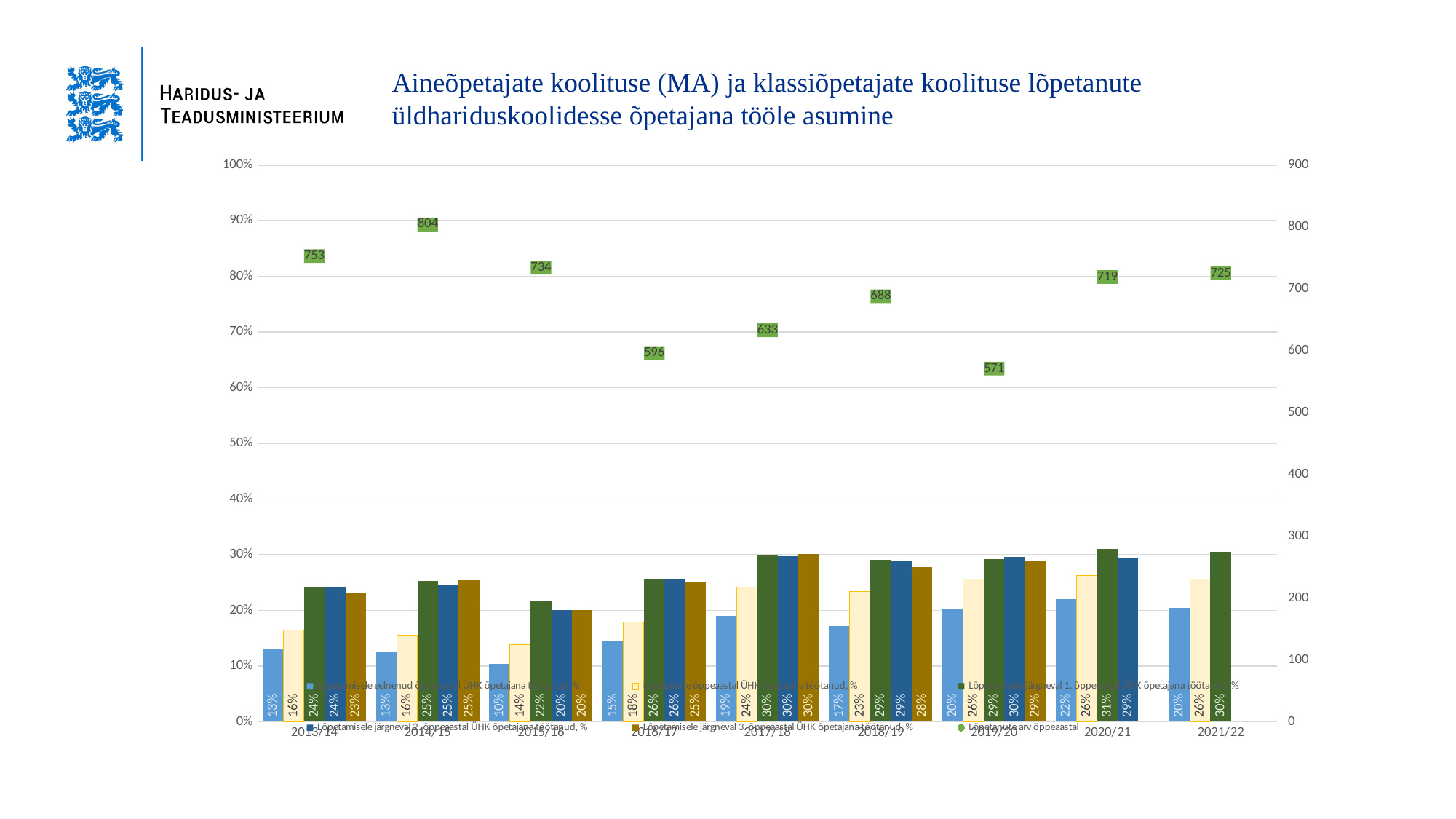
How many series does the legend list? 6 Which academic year has the highest number of graduates? 2014/15 Which academic year has the lowest number of graduates? 2019/20 What is the value of the dark green bar for 2020/21? 31% What is the value of the light blue bar (first bar) for 2015/16? 10% How many academic years are shown on the x axis? 9 Is the number of graduates in 2017/18 greater or less than 600? greater What is the difference between the number of graduates in 2013/14 and in 2016/17? 157 What is the number of graduates (Lõpetanute arv õppeaastal) shown for 2014/15? 804 Which is larger: the number of graduates in 2020/21 or in 2021/22? 2021/22 What is the number of graduates shown for 2019/20? 571 What kind of chart is this? Combined bar and scatter (marker) chart